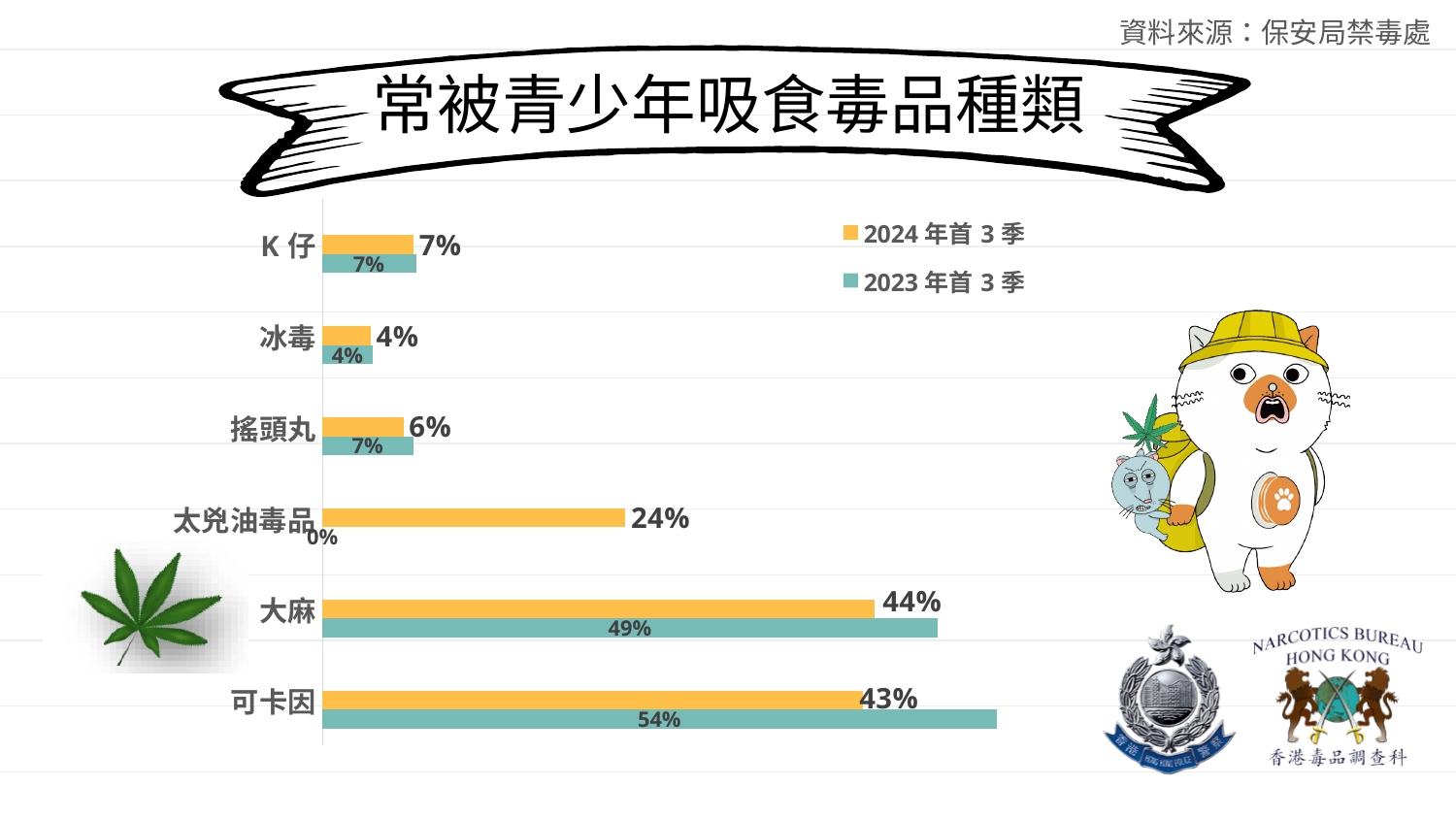
Which category has the lowest value in the 2024 年首 3 季 series? 冰毒 Which category has the highest value in the 2023 年首 3 季 series? 可卡因 What kind of chart is shown on the slide? bar chart How many series does the legend list? 2 What is the value for 可卡因 in the 2023 年首 3 季 series? 54% How many categories are shown on the chart? 6 What is the difference between the 2023 年首 3 季 and 2024 年首 3 季 values for 可卡因? 11% What is the value for 太兇油毒品 in the 2024 年首 3 季 series? 24% What is the value for 大麻 in the 2024 年首 3 季 series? 44% What is the title of the chart? 常被青少年吸食毒品種類 What is the value for 搖頭丸 in the 2023 年首 3 季 series? 7% Which is larger for 大麻: the 2024 年首 3 季 value or the 2023 年首 3 季 value? 2023 年首 3 季